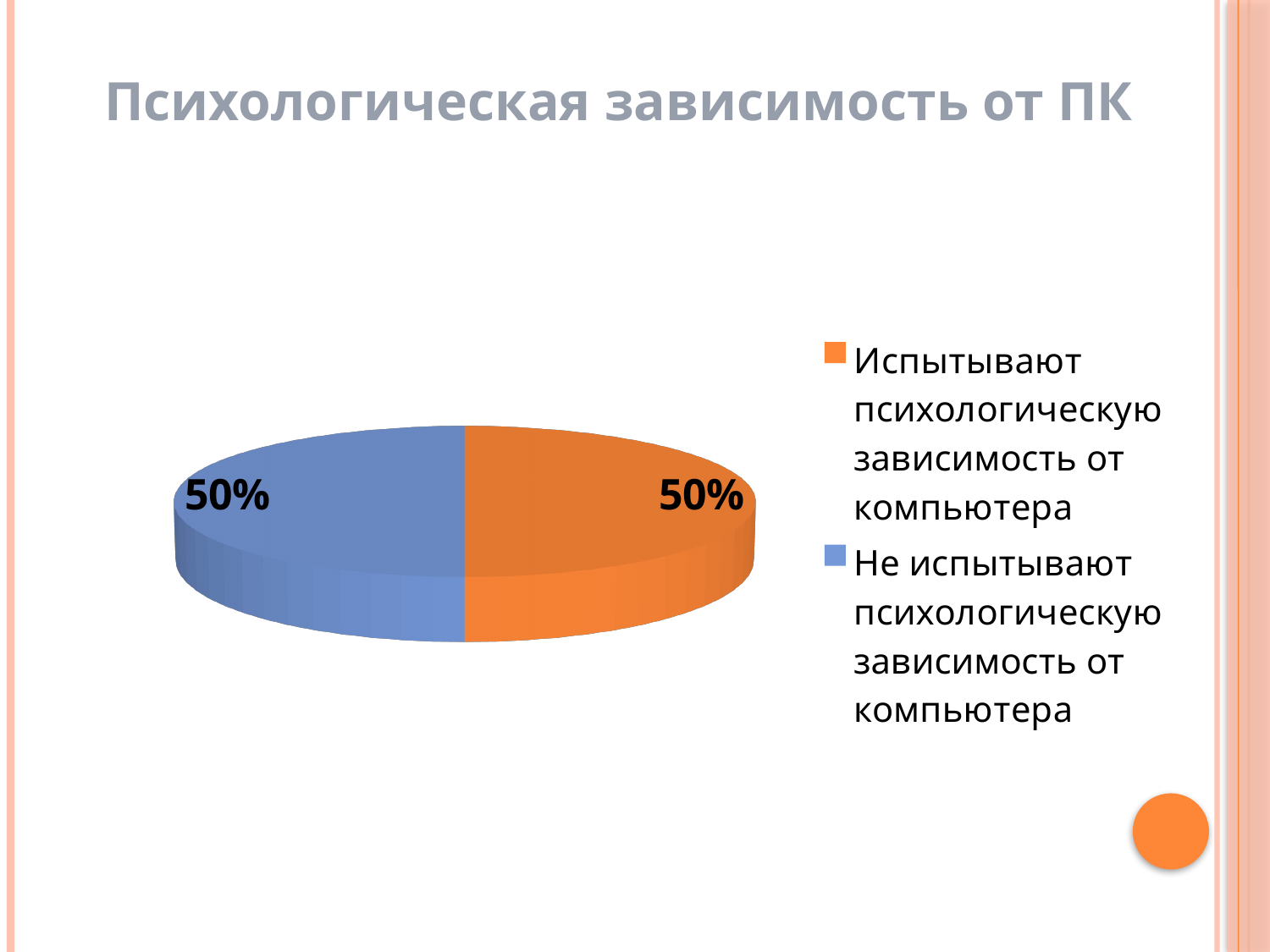
How many entries does the legend list? 2 What share of the pie is labelled "Не испытывают психологическую зависимость от компьютера"? 50% What share of the pie does the orange slice represent? 50% How many slices does the pie chart have? 2 What is the title of the slide containing the chart? Психологическая зависимость от ПК Which colour represents "Не испытывают психологическую зависимость от компьютера" in the pie chart? Blue What kind of chart is shown on the slide? Pie chart What is the difference between the share of those who experience psychological dependence on the computer and those who do not? 0% What share of the pie is labelled "Испытывают психологическую зависимость от компьютера"? 50% What is the combined share of the two slices in the pie chart? 100%